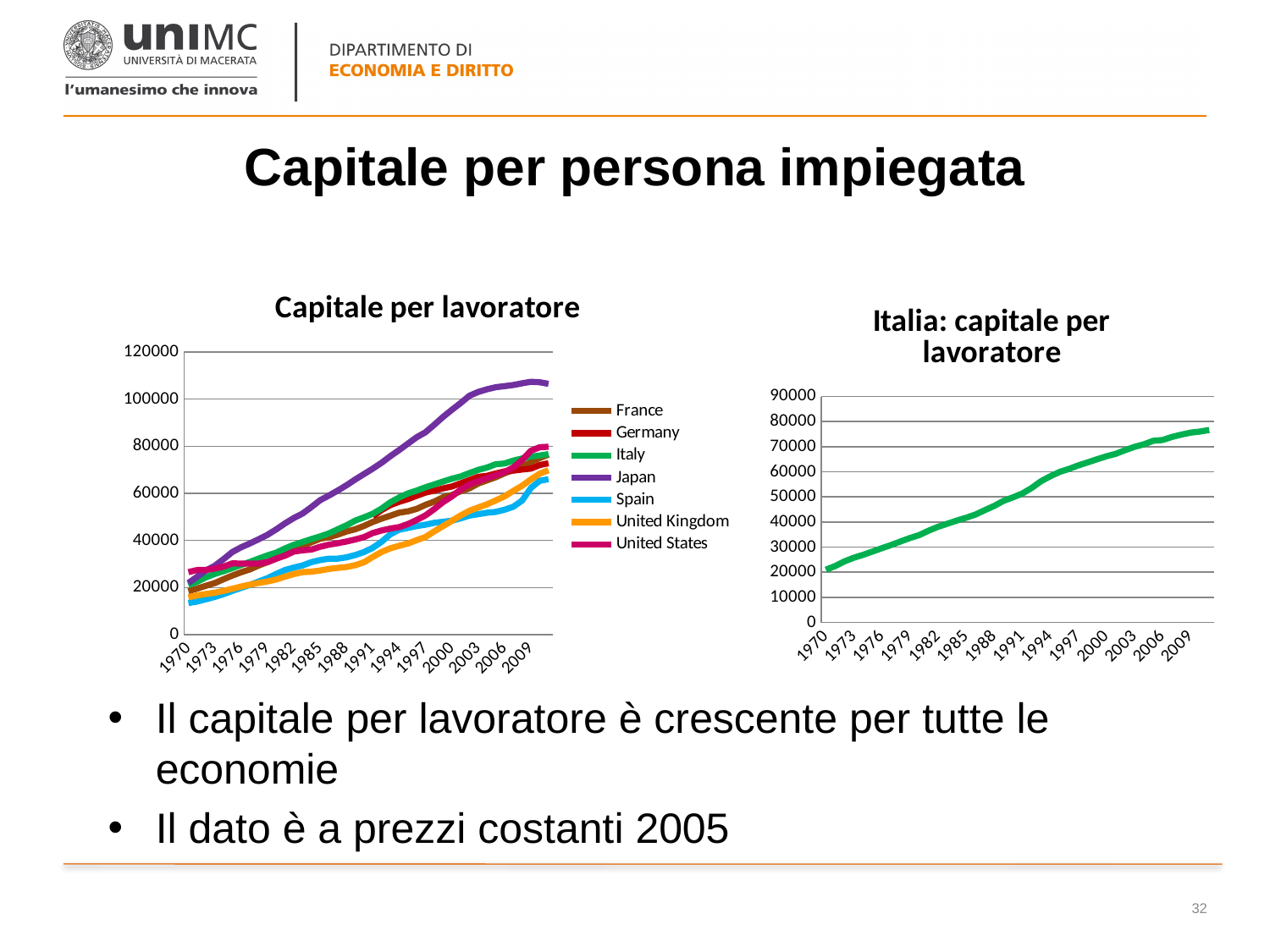
In the "Capitale per lavoratore" chart, which country has the lowest value in 1970? Spain What type of chart is the "Italia: capitale per lavoratore" chart on the right? line chart In the "Capitale per lavoratore" chart, is the value for Spain in 1970 greater or less than 20000? less How many series does the legend of the "Capitale per lavoratore" chart list? 7 In the "Capitale per lavoratore" chart, do the values for Japan rise or fall from 1970 to 2009? rise What type of chart is the "Capitale per lavoratore" chart on the left? line chart In the "Capitale per lavoratore" chart, is the value for Japan in 2009 greater or less than 100000? greater In the "Capitale per lavoratore" chart, which country has the highest value in 2009? Japan In the "Italia: capitale per lavoratore" chart, do the values rise or fall along the x axis? rise In the "Italia: capitale per lavoratore" chart, is the value in 2009 greater or less than 70000? greater In the "Capitale per lavoratore" chart, which is larger in 2009, the value for Japan or the value for Spain? Japan